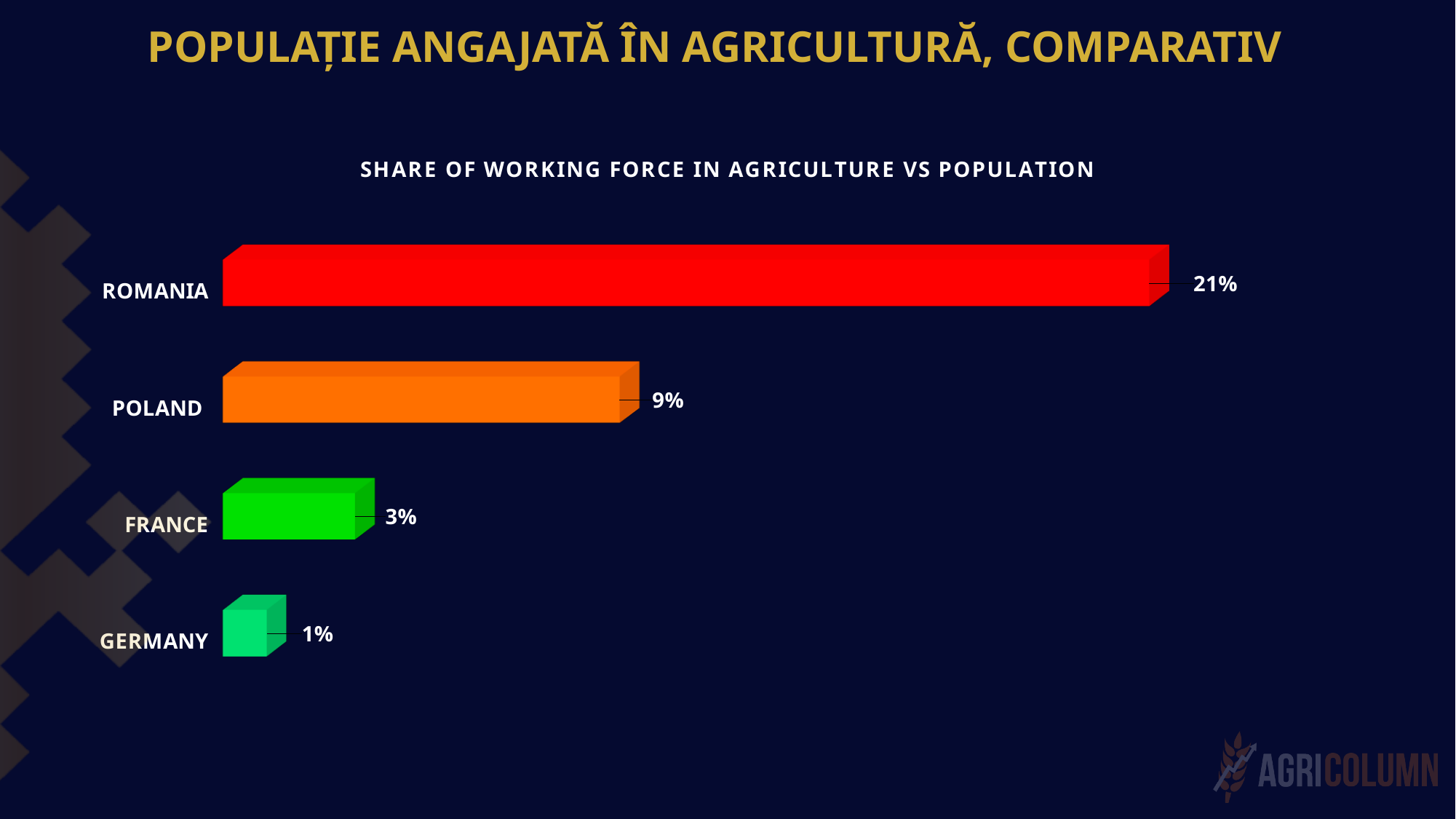
What is the value for Germany? 1% What is the difference between the values for Romania and Poland? 12% Which country has the highest share of working force in agriculture? Romania How many countries are shown in the chart? 4 What kind of chart is shown on the slide? Bar chart Which country has the lowest share of working force in agriculture? Germany What is the title of the chart? SHARE OF WORKING FORCE IN AGRICULTURE VS POPULATION What is the difference between the values for France and Germany? 2% Which is larger, the value for Poland or the value for France? Poland What is the value for France? 3% What is the value for Romania? 21% What is the value for Poland? 9%